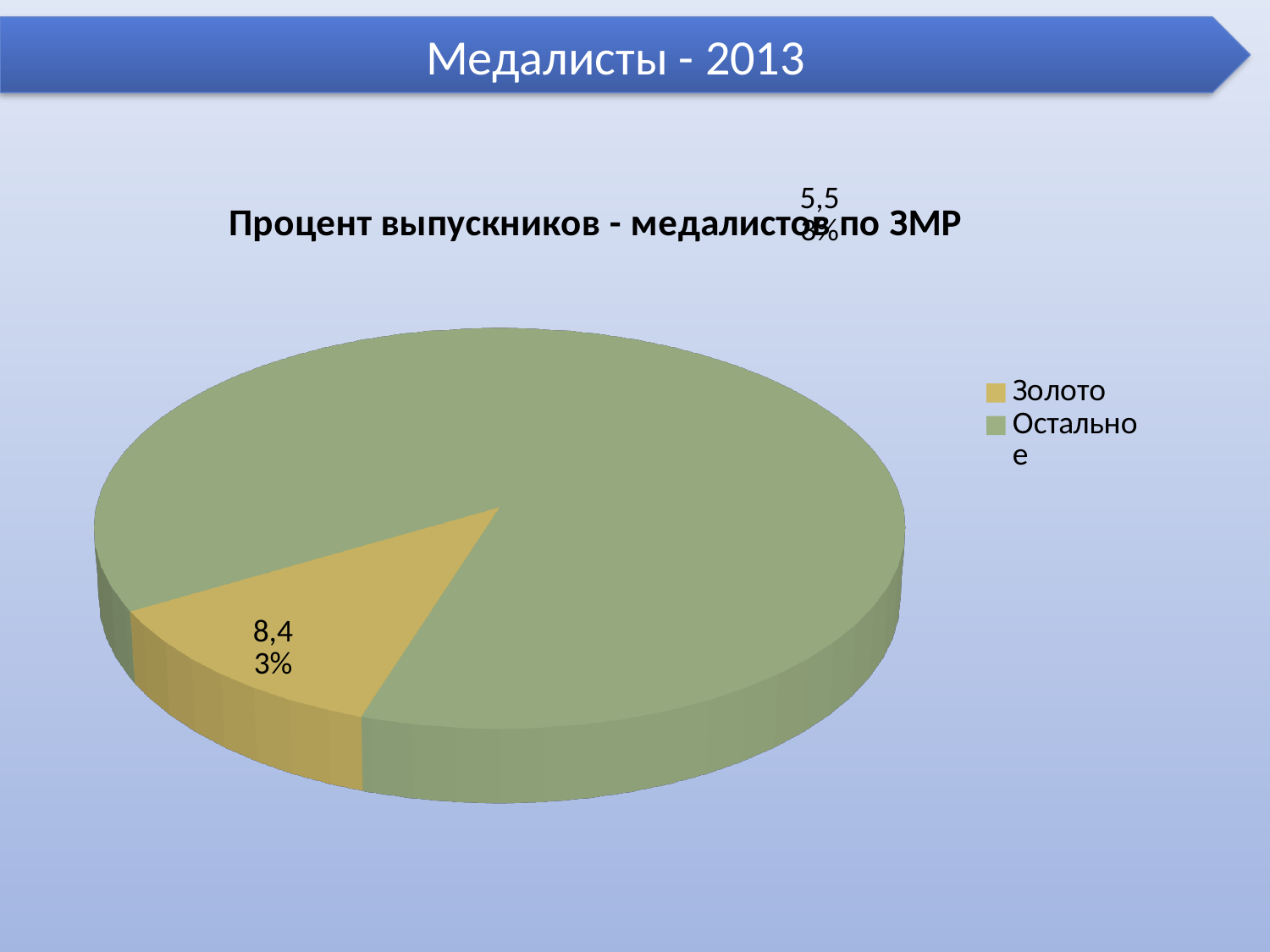
What is the title of the chart? Процент выпускников - медалистов по ЗМР Which category has the largest slice of the pie? Остальное What colour is the Золото slice in the pie chart? gold (yellow) How many categories does the legend of the pie chart list? 2 What kind of chart is shown on the slide? pie chart Which category takes the larger share of the pie, Золото or Остальное? Остальное Is the Золото slice greater or less than half of the pie? less Which category has the smallest slice of the pie? Золото Is the Остальное slice greater or less than half of the pie? greater